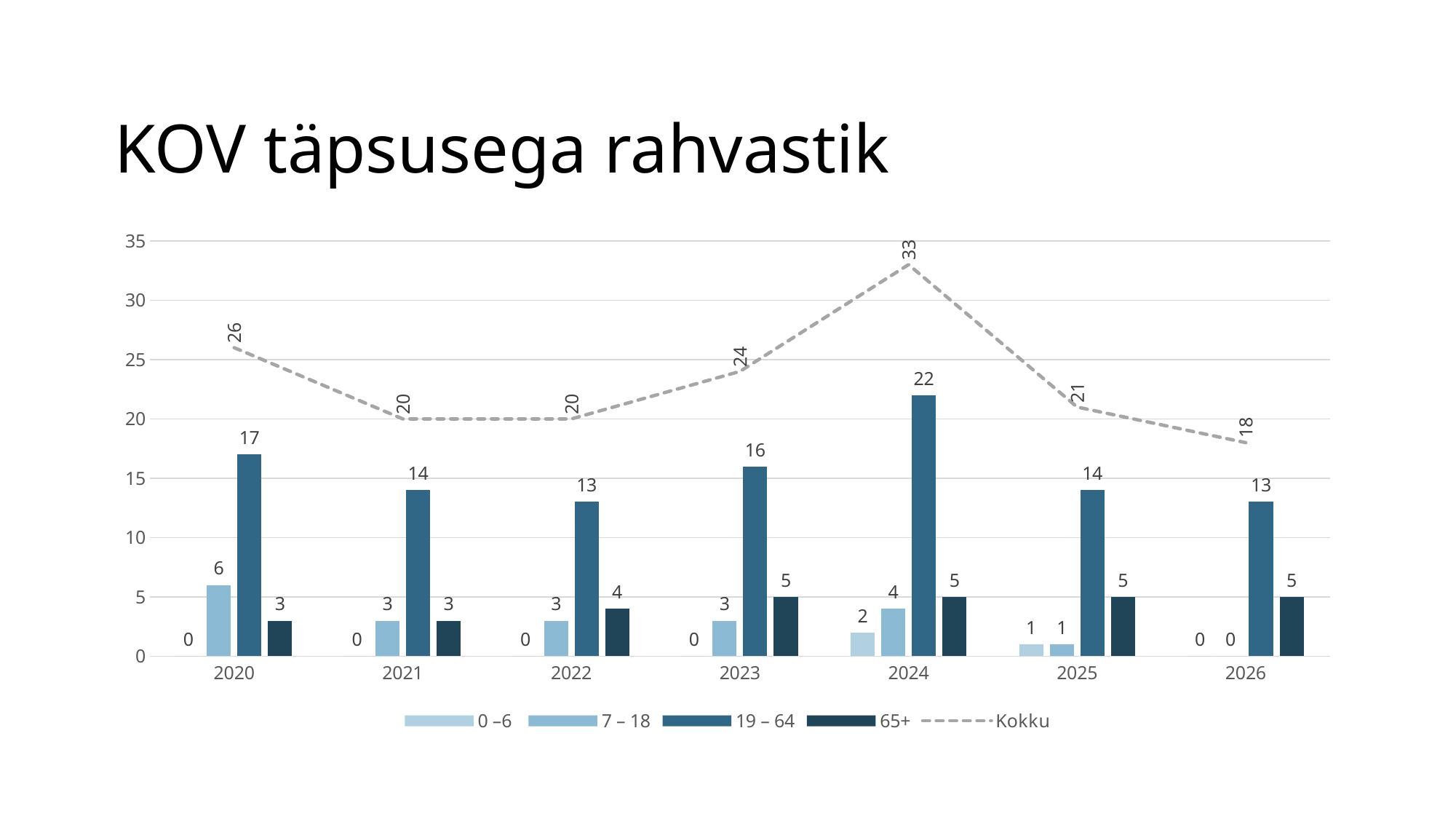
What is the Kokku value for 2020? 26 What is the difference between the Kokku values for 2024 and 2025? 12 What is the title of the slide? KOV täpsusega rahvastik What is the value for the 19 – 64 series in 2024? 22 In which year is the Kokku line lowest? 2026 Is the Kokku value for 2023 greater or less than 20? greater How many series does the legend list? 5 In which year is the Kokku line highest? 2024 What kind of chart is shown on the slide? Combined bar and line chart What is the value for the 7 – 18 series in 2020? 6 How many years are shown on the x axis? 7 Which is larger, the 19 – 64 value in 2023 or in 2025? 2023